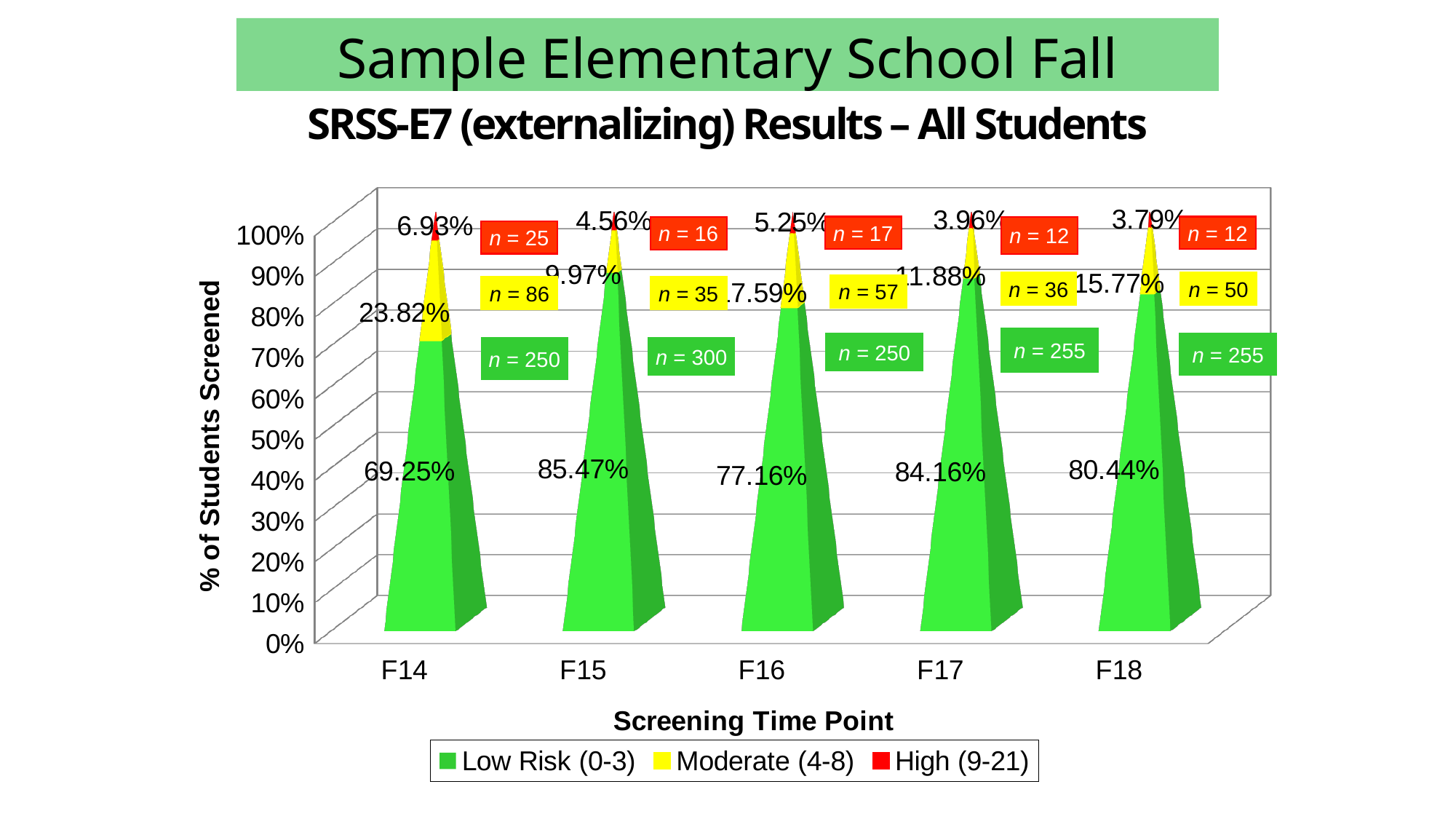
What is the Moderate (4-8) percentage for F18? 15.77% What is the Low Risk (0-3) percentage for F14? 69.25% Which has a larger Moderate (4-8) percentage, F14 or F17? F14 Which screening time point has the lowest Low Risk (0-3) percentage? F14 What is the title of the x axis? Screening Time Point What kind of chart is shown on the slide? Stacked bar chart What is the difference between the Low Risk (0-3) percentages for F15 and F14? 16.22% What is the Low Risk (0-3) percentage for F17? 84.16% Which screening time point has the highest Low Risk (0-3) percentage? F15 How many screening time points are shown on the x axis? 5 How many series does the legend list? 3 What is the High (9-21) percentage for F15? 4.56%